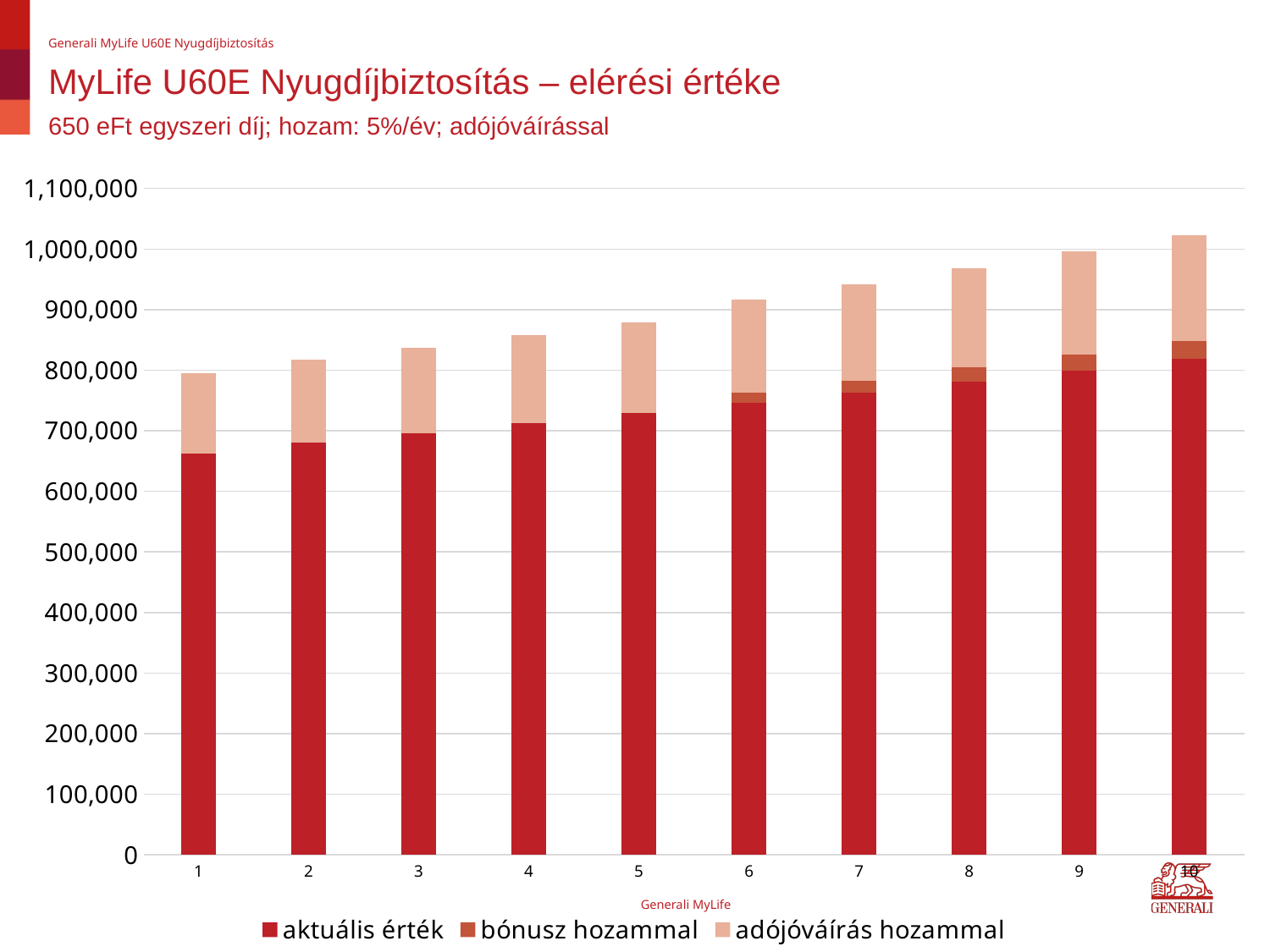
Is the total stacked value for category 5 greater or less than 800,000? greater How many categories (years) are shown on the x axis of the chart? 10 Is the 'aktuális érték' value for category 1 greater or less than 600,000? greater Is the total stacked value for category 8 greater or less than 1,000,000? less Do the total bar heights rise or fall from category 1 to category 10? rise Which has the larger total stacked value, category 7 or category 3? category 7 Which category has the shortest stacked bar in the chart? 1 How many series does the chart legend list? 3 What kind of chart is shown on the slide? stacked bar chart Which series is shown in the lightest colour in the chart legend? adójóváírás hozammal Which category has the tallest stacked bar in the chart? 10